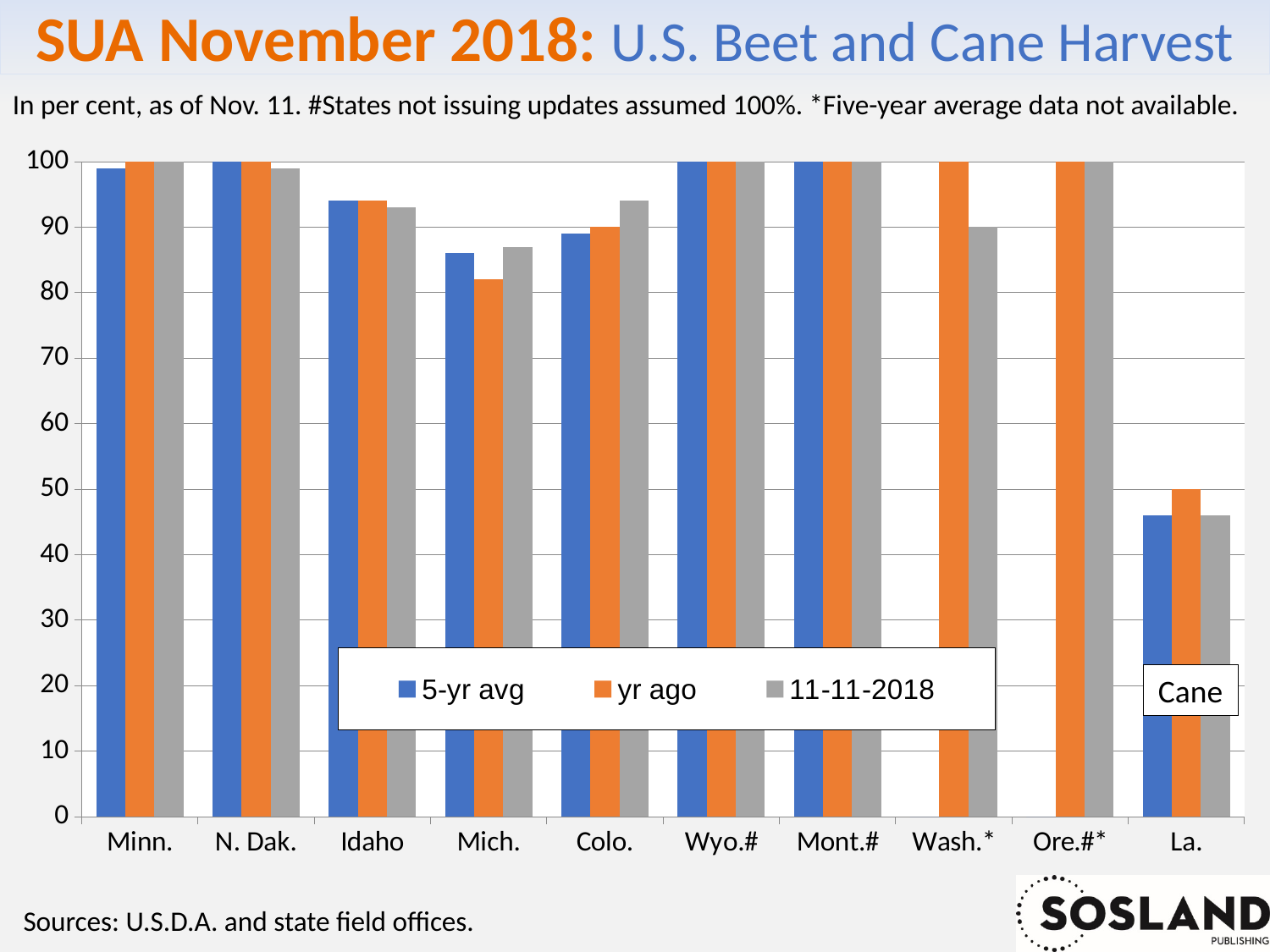
Is the 5-yr avg value for La. greater or less than 50? less Which state has the lowest 11-11-2018 harvest value? La. What is the 11-11-2018 value for Wyo.#? 100 Is the yr ago value for Mich. greater or less than 90? less How many states are shown along the x axis? 10 Which legend entry is shown in gray? 11-11-2018 What kind of chart is shown on the slide? bar chart What is the 11-11-2018 value for Wash.*? 90 What is the yr ago value for La.? 50 How many series does the legend list? 3 Is the 11-11-2018 value for Idaho greater or less than 90? greater For Mich., which is larger: the 5-yr avg value or the yr ago value? 5-yr avg